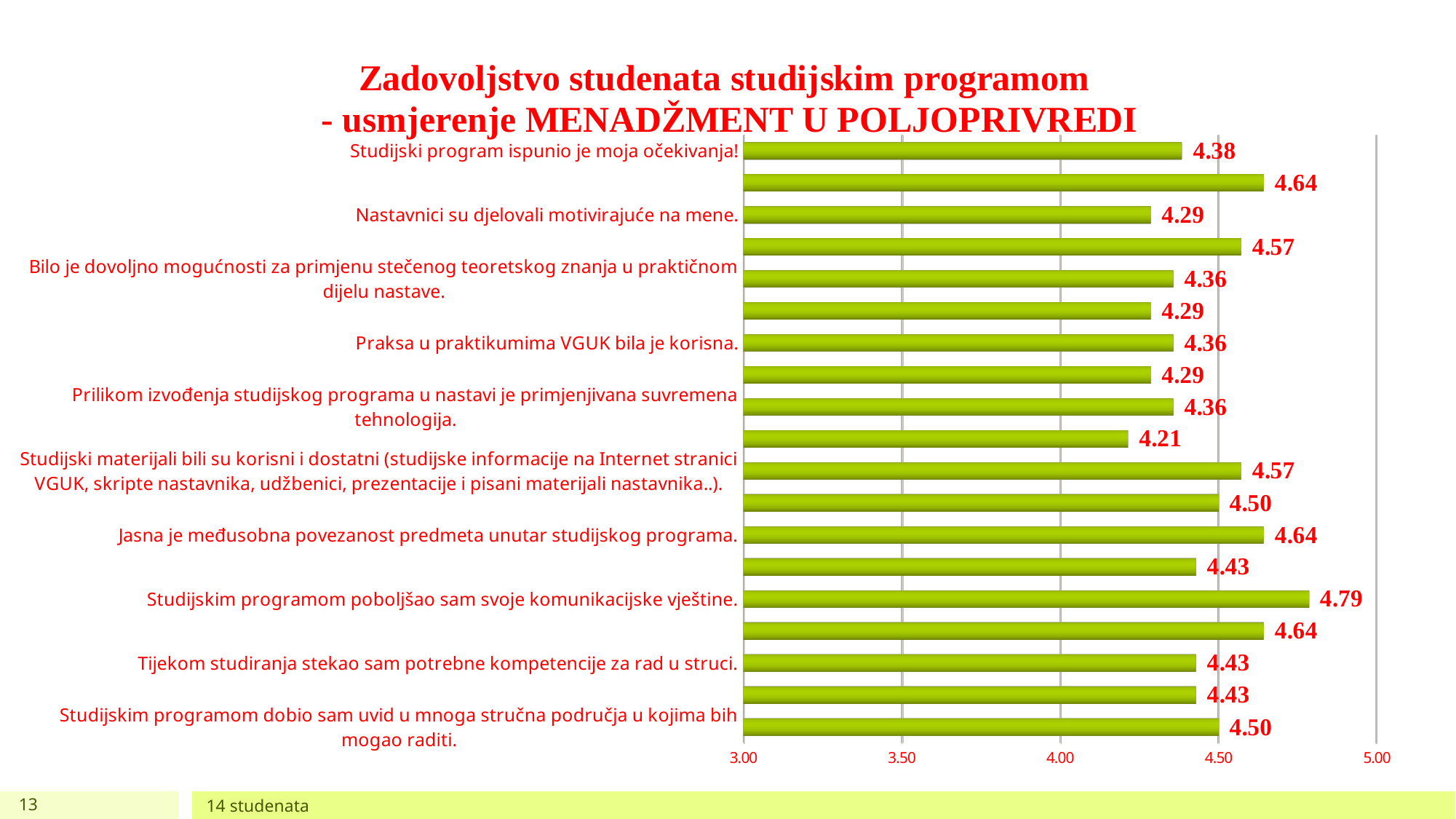
Which labelled statement has the highest value in the chart? Studijskim programom poboljšao sam svoje komunikacijske vještine. How many bars are plotted in the chart? 19 What is the maximum value shown on the horizontal axis of the chart? 5.00 Which has a larger value: "Praksa u praktikumima VGUK bila je korisna." or "Studijski materijali bili su korisni i dostatni (studijske informacije na Internet stranici VGUK, skripte nastavnika, udžbenici, prezentacije i pisani materijali nastavnika..)."? Studijski materijali bili su korisni i dostatni (studijske informacije na Internet stranici VGUK, skripte nastavnika, udžbenici, prezentacije i pisani materijali nastavnika..). What is the difference between the value for "Studijskim programom poboljšao sam svoje komunikacijske vještine." and the value for "Nastavnici su djelovali motivirajuće na mene."? 0.50 What type of chart is shown on the slide? bar chart What is the value for "Studijskim programom poboljšao sam svoje komunikacijske vještine."? 4.79 What is the value for "Jasna je međusobna povezanost predmeta unutar studijskog programa."? 4.64 What is the value for "Tijekom studiranja stekao sam potrebne kompetencije za rad u struci."? 4.43 What is the value for "Nastavnici su djelovali motivirajuće na mene."? 4.29 What is the value for "Studijski program ispunio je moja očekivanja!"? 4.38 What is the lowest value shown on any bar in the chart? 4.21